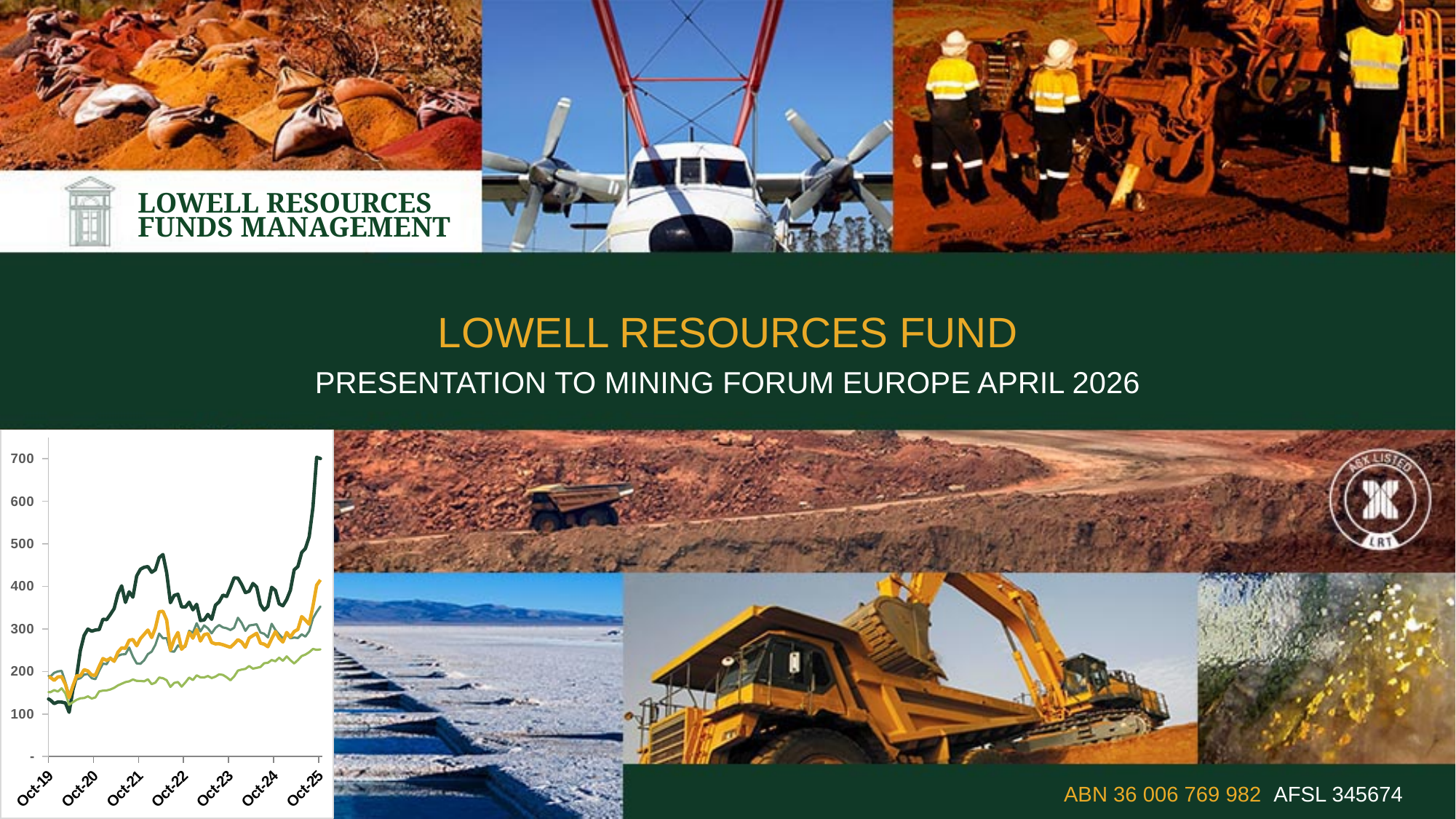
On the chart at the bottom left, is the value of the dark green line at Oct-19 greater or less than 200? less On the chart at the bottom left, which line ends lowest at Oct-25? the light green line What is the first date label on the x axis of the chart at the bottom left? Oct-19 On the chart at the bottom left, does the light green line generally rise or fall from Oct-19 to Oct-25? rise What is the last date label on the x axis of the chart at the bottom left? Oct-25 On the chart at the bottom left, is the value of the orange line at Oct-25 greater or less than 500? less What kind of chart is shown at the bottom left of the slide? line chart On the chart at the bottom left, is the value of the dark green line at Oct-25 greater or less than 600? greater On the chart at the bottom left, which line ends highest at Oct-25? the dark green line How many date labels are shown on the x axis of the chart at the bottom left? 7 How many lines are plotted on the chart at the bottom left? 4